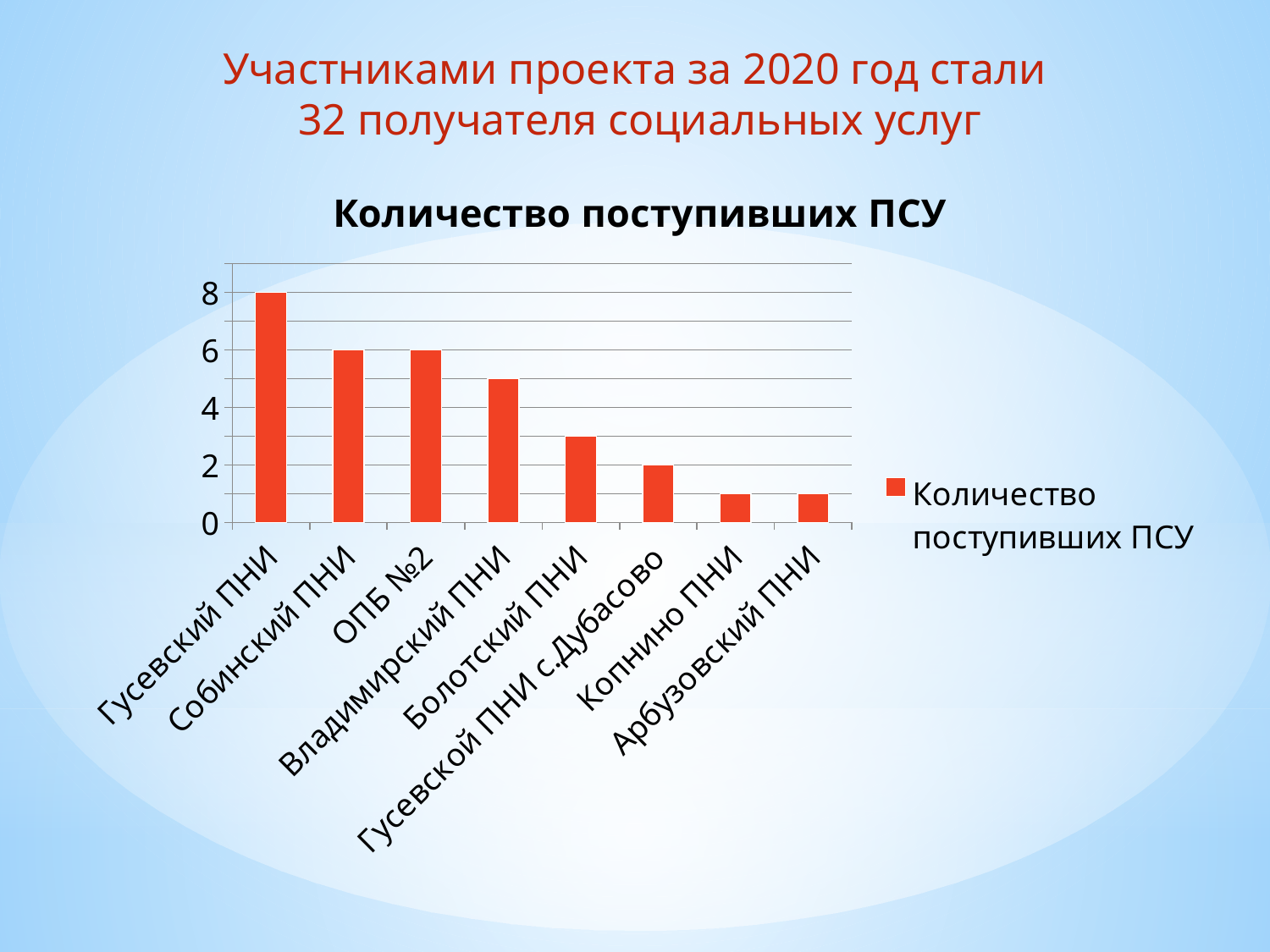
How many categories are shown on the x axis of the chart? 8 What is the difference between the values for Гусевский ПНИ and ОПБ №2? 2 Is the value for Копнино ПНИ greater or less than 2? less What is the value for Собинский ПНИ? 6 What type of chart is shown on the slide? Bar chart Do the values rise or fall from left to right along the x axis? Fall What is the value for Гусевской ПНИ с.Дубасово? 2 Which category has the highest value in the chart? Гусевский ПНИ Is the value for Владимирский ПНИ greater or less than 4? greater What is the title of the chart? Количество поступивших ПСУ How many series does the legend list? 1 What is the value for Гусевский ПНИ? 8